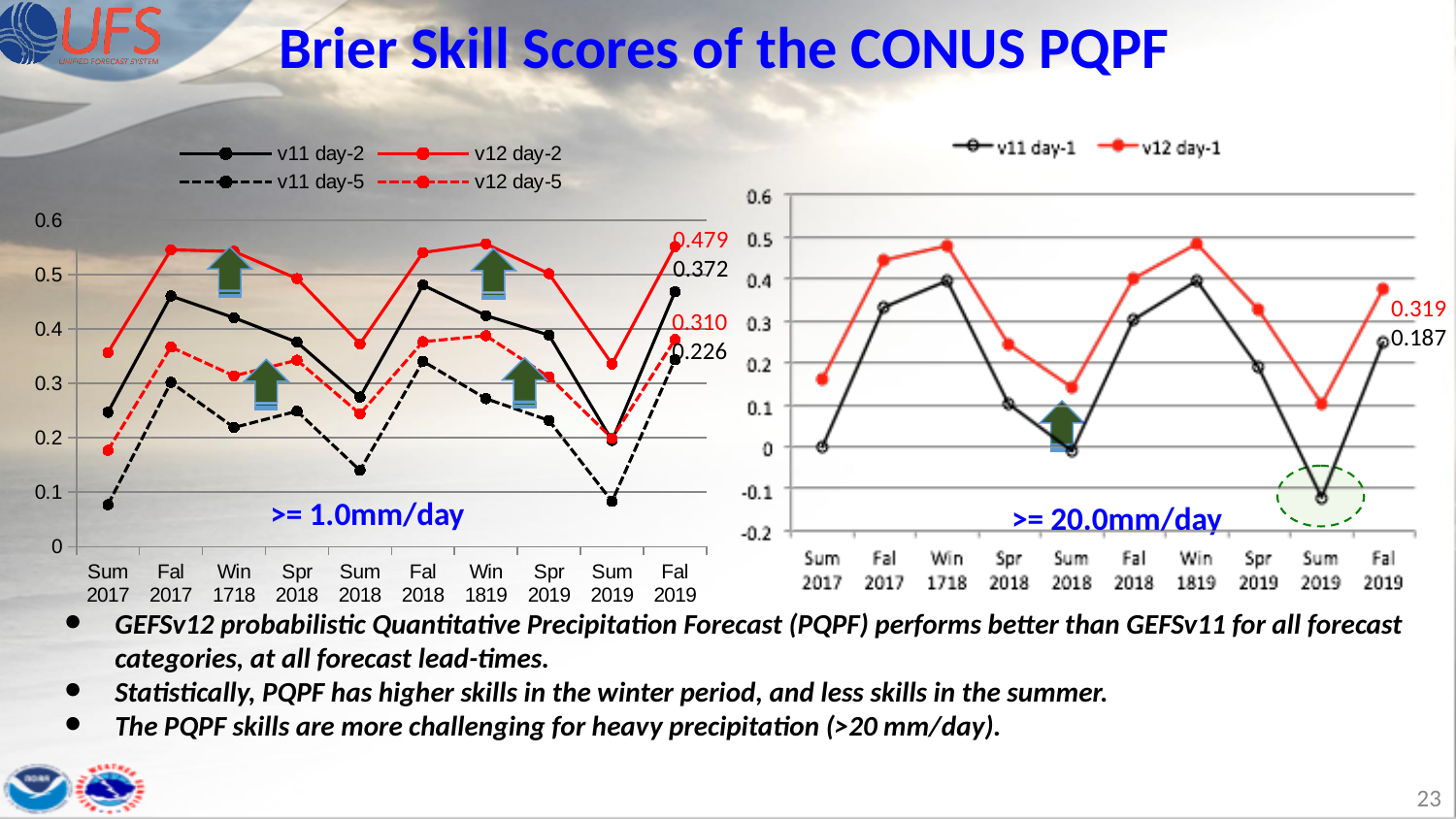
How many seasons are shown along the x axis of the right chart (>= 20.0mm/day)? 10 How many series does the legend of the right chart (>= 20.0mm/day) list? 2 In the right chart (>= 20.0mm/day), is the value for v11 day-1 at Sum 2019 greater or less than 0? less In the right chart (>= 20.0mm/day), at which season is v11 day-1 lowest? Sum 2019 How many series does the legend of the left chart (>= 1.0mm/day) list? 4 What kind of chart is the left chart (>= 1.0mm/day)? line chart